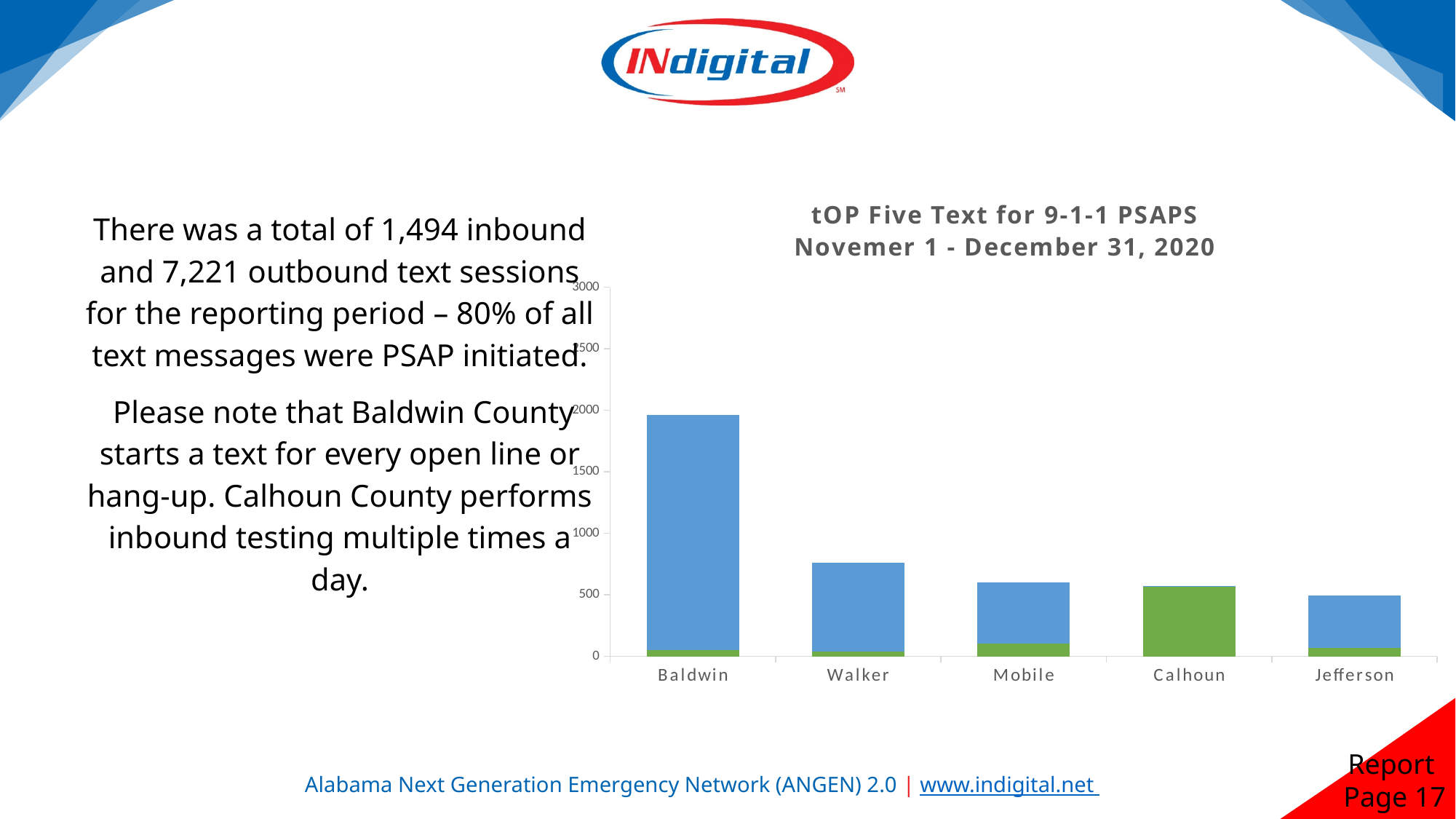
Is the total bar height for Walker greater or less than 500? greater Is the total bar height for Baldwin greater or less than 1500? greater How many PSAPs (categories) are shown on the x axis of the chart? 5 Which PSAP's bar is made up entirely of the green segment? Calhoun Which bar is taller, Walker or Mobile? Walker Which PSAP has the tallest bar in the chart? Baldwin Is the total bar height for Calhoun greater or less than 1000? less Which PSAP has the shortest bar in the chart? Jefferson Do the bar heights rise or fall moving from Baldwin on the left to Jefferson on the right? fall What kind of chart is shown on the slide? bar chart